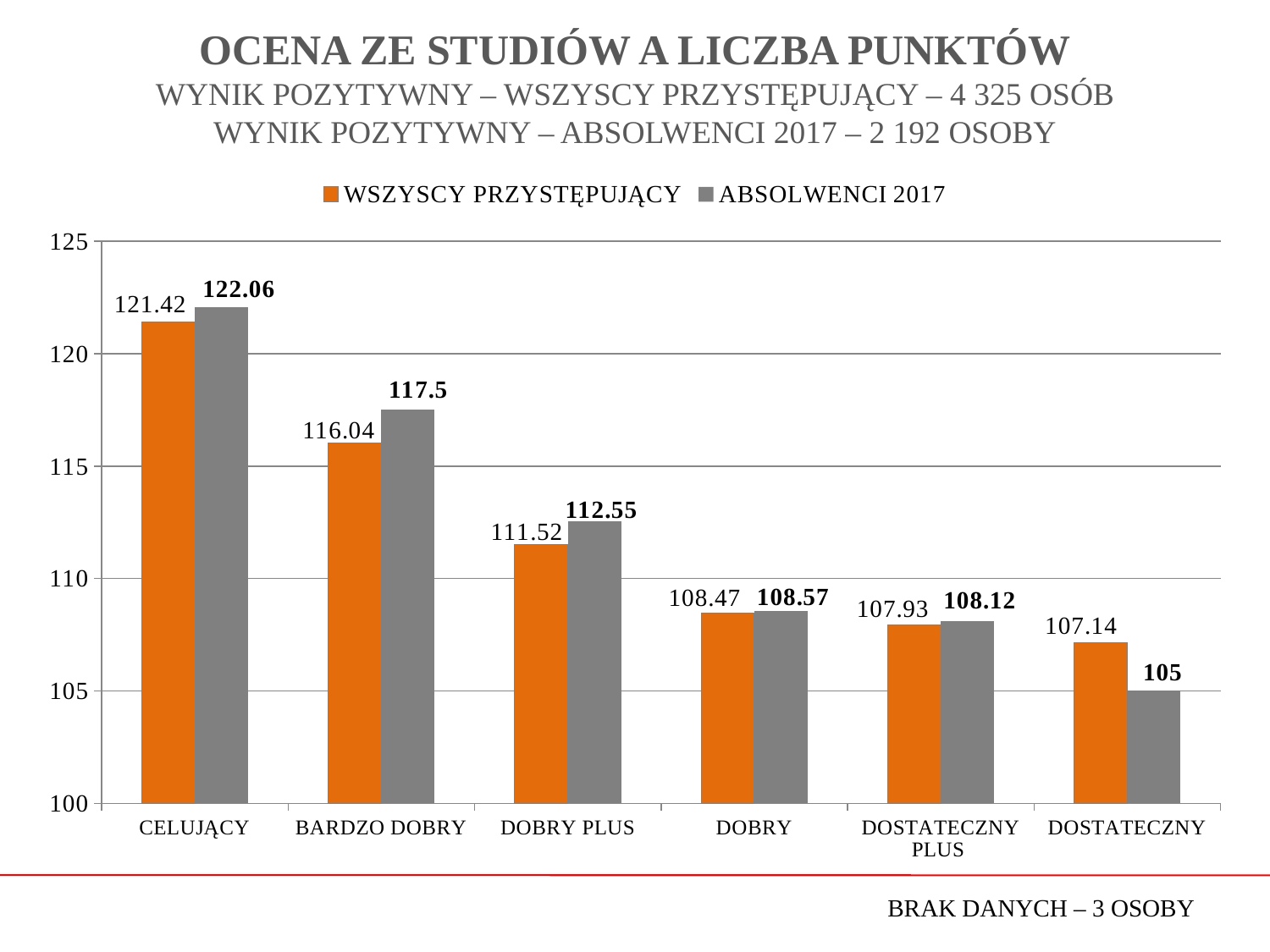
What kind of chart is shown on the slide? bar chart Is the value for DOBRY PLUS in the WSZYSCY PRZYSTĘPUJĄCY series greater or less than 110? greater How many categories are shown on the x axis? 6 How many series does the legend list? 2 What is the value for BARDZO DOBRY in the ABSOLWENCI 2017 series? 117.5 Which category has the lowest value in the WSZYSCY PRZYSTĘPUJĄCY series? DOSTATECZNY What is the difference between the ABSOLWENCI 2017 and WSZYSCY PRZYSTĘPUJĄCY values for BARDZO DOBRY? 1.46 Which category has the highest value in the ABSOLWENCI 2017 series? CELUJĄCY For DOSTATECZNY, which series has the larger value: WSZYSCY PRZYSTĘPUJĄCY or ABSOLWENCI 2017? WSZYSCY PRZYSTĘPUJĄCY What is the value for CELUJĄCY in the WSZYSCY PRZYSTĘPUJĄCY series? 121.42 What is the value for DOSTATECZNY in the ABSOLWENCI 2017 series? 105 Do the values in the WSZYSCY PRZYSTĘPUJĄCY series rise or fall from CELUJĄCY to DOSTATECZNY? fall